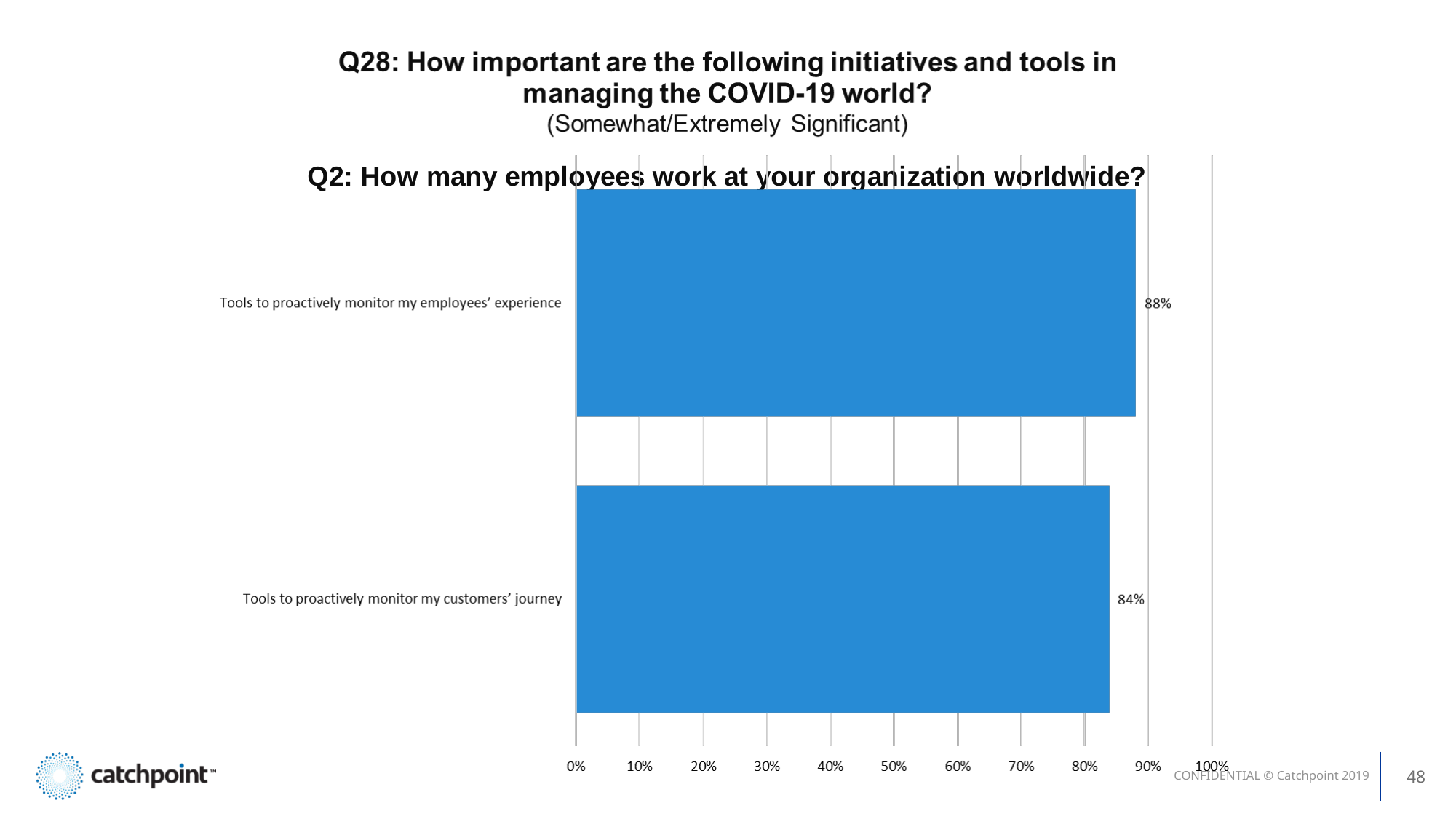
What percentage of respondents rated tools to proactively monitor my employees' experience as somewhat/extremely significant? 88% Which is larger: the value for tools to proactively monitor my employees' experience or the value for tools to proactively monitor my customers' journey? Tools to proactively monitor my employees' experience What is the difference in percentage points between tools to monitor employees' experience and tools to monitor customers' journey? 4 percentage points Which initiative has the lowest percentage in the chart? Tools to proactively monitor my customers' journey How many initiatives are shown in the chart? 2 What type of chart is shown on the slide? Bar chart Which initiative has the highest percentage in the chart? Tools to proactively monitor my employees' experience What percentage of respondents rated tools to proactively monitor my customers' journey as somewhat/extremely significant? 84% What is the maximum value shown on the horizontal axis of the chart? 100% Is the value for tools to proactively monitor my customers' journey greater or less than 90%? less Is the value for tools to proactively monitor my employees' experience greater or less than 80%? greater What colour are the bars in the chart? Blue